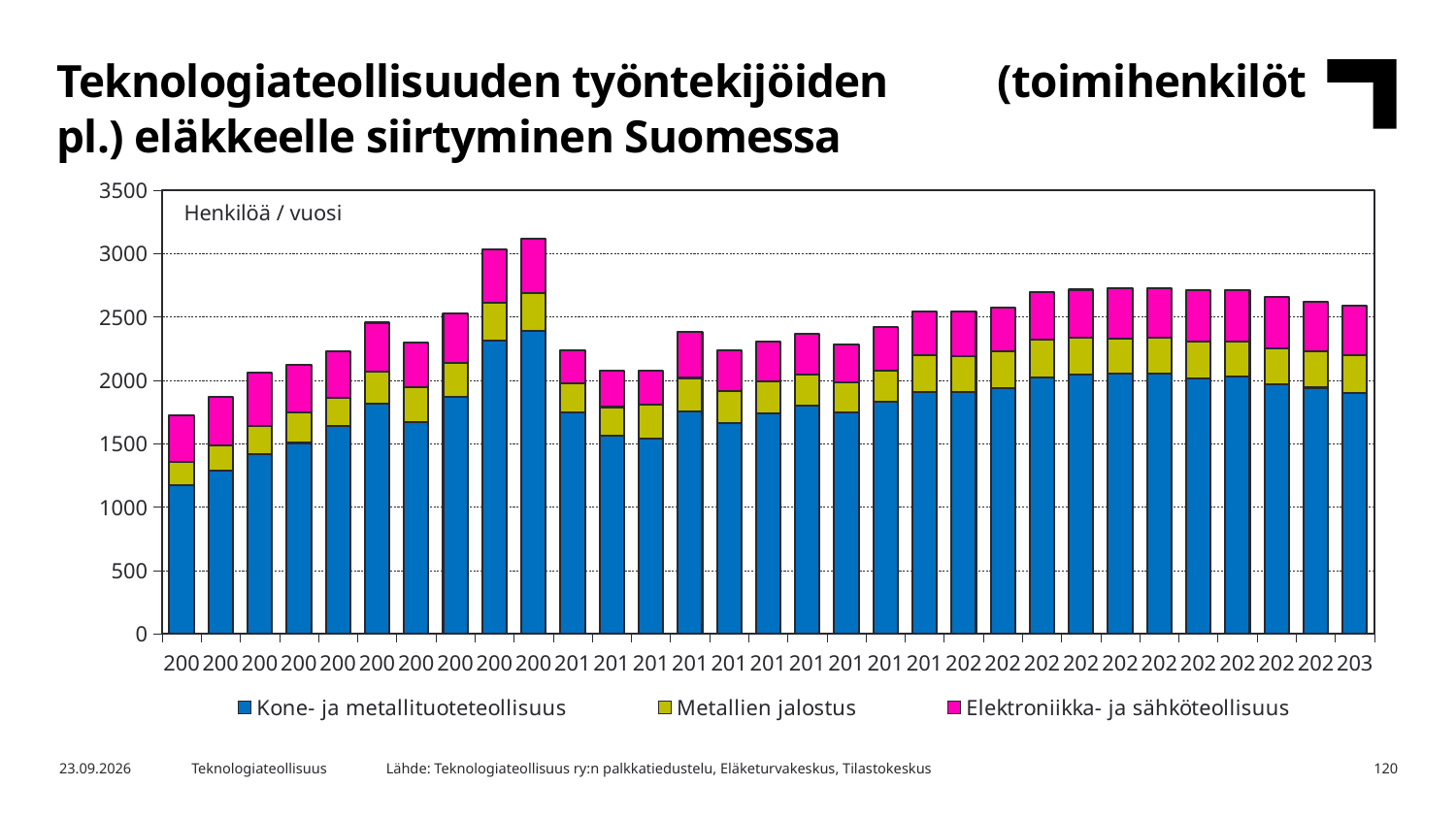
What is the highest value shown on the vertical axis? 3500 How many series does the legend list? 3 How many bars are plotted in the chart? 31 Which series forms the largest segment in every bar? Kone- ja metallituoteteollisuus Which series is shown in blue in the legend? Kone- ja metallituoteteollisuus Which series is shown in pink/magenta in the legend? Elektroniikka- ja sähköteollisuus Is the total of the rightmost bar greater or less than 2500? greater Is the total of the leftmost bar greater or less than 2000? less Overall, do the bar totals rise or fall from the leftmost bar to the rightmost bar? rise What kind of chart is shown on the slide? Stacked bar chart What unit label is printed inside the chart area? Henkilöä / vuosi Is the total of the tallest bar greater or less than 3000? greater